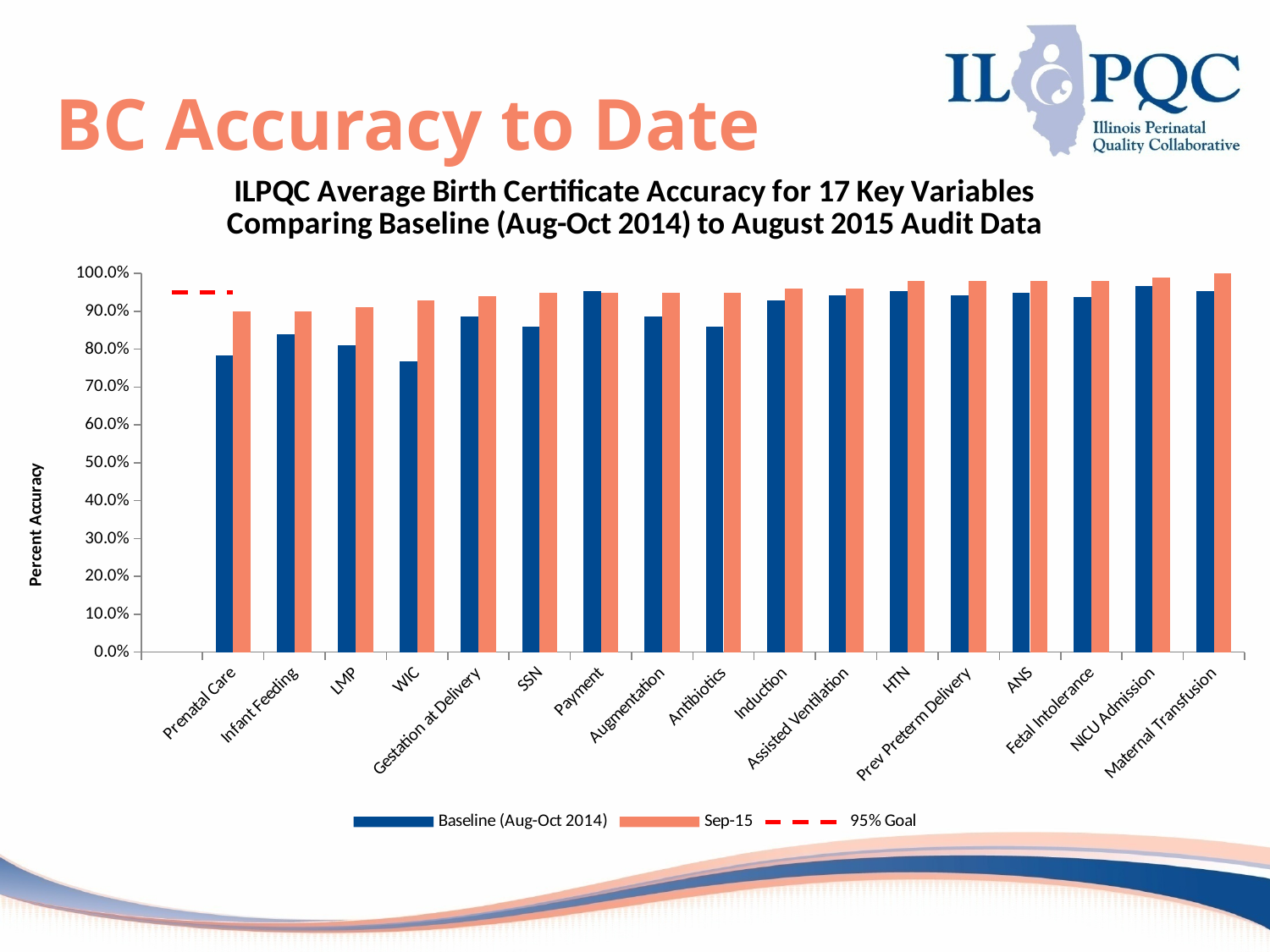
Is the Baseline (Aug-Oct 2014) value for Antibiotics greater or less than 90.0%? less What is the label on the chart's y axis? Percent Accuracy Is the Baseline (Aug-Oct 2014) value for WIC greater or less than 80.0%? less How many categories (variables) are shown along the x axis of the chart? 17 What kind of chart is shown on the slide? bar chart Is the Sep-15 value for Maternal Transfusion greater or less than 90.0%? greater For WIC, which is larger: the Baseline (Aug-Oct 2014) value or the Sep-15 value? Sep-15 How many entries does the chart's legend list? 3 For Prenatal Care, which is larger: the Baseline (Aug-Oct 2014) value or the Sep-15 value? Sep-15 What does the red dashed line in the chart represent, according to the legend? 95% Goal